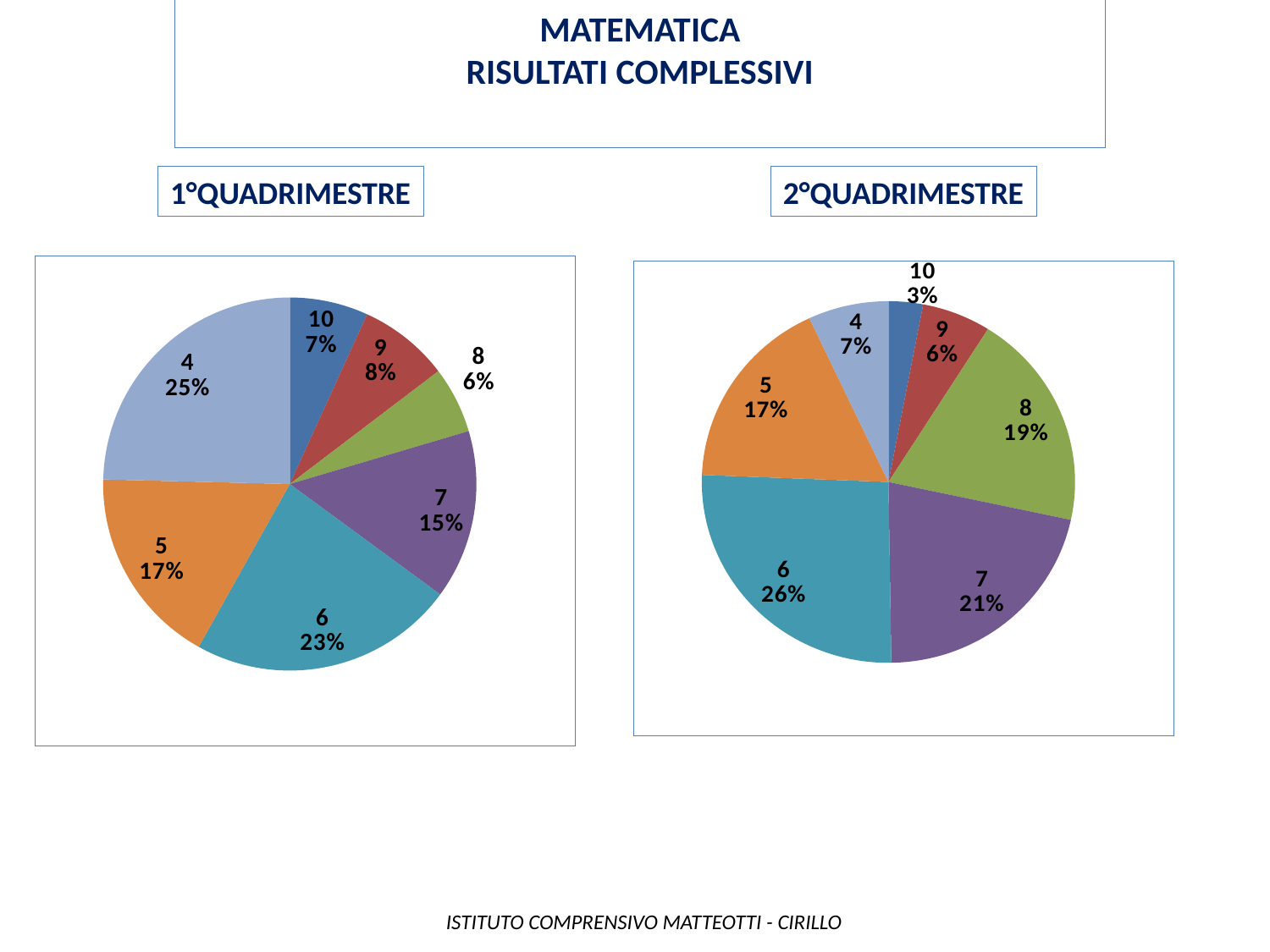
How many slices does the 1°QUADRIMESTRE pie chart have? 7 In the 1°QUADRIMESTRE pie chart, which is larger: the share of grade 6 or the share of grade 7? 6 In the 1°QUADRIMESTRE pie chart, which grade has the smallest slice? 8 In the 2°QUADRIMESTRE pie chart, which grade has the smallest slice? 10 In the 1°QUADRIMESTRE pie chart, which grade has the largest slice? 4 In the 2°QUADRIMESTRE pie chart, which grade has the largest slice? 6 In the 2°QUADRIMESTRE pie chart, what share does grade 10 have? 3% What type of chart is used for the 2°QUADRIMESTRE results? Pie chart What is the title shown at the top of the slide? MATEMATICA RISULTATI COMPLESSIVI In the 2°QUADRIMESTRE pie chart, what share does grade 6 have? 26% In the 1°QUADRIMESTRE pie chart, what share does grade 4 have? 25% In the 2°QUADRIMESTRE pie chart, what is the difference between the shares of grade 7 and grade 8? 2%